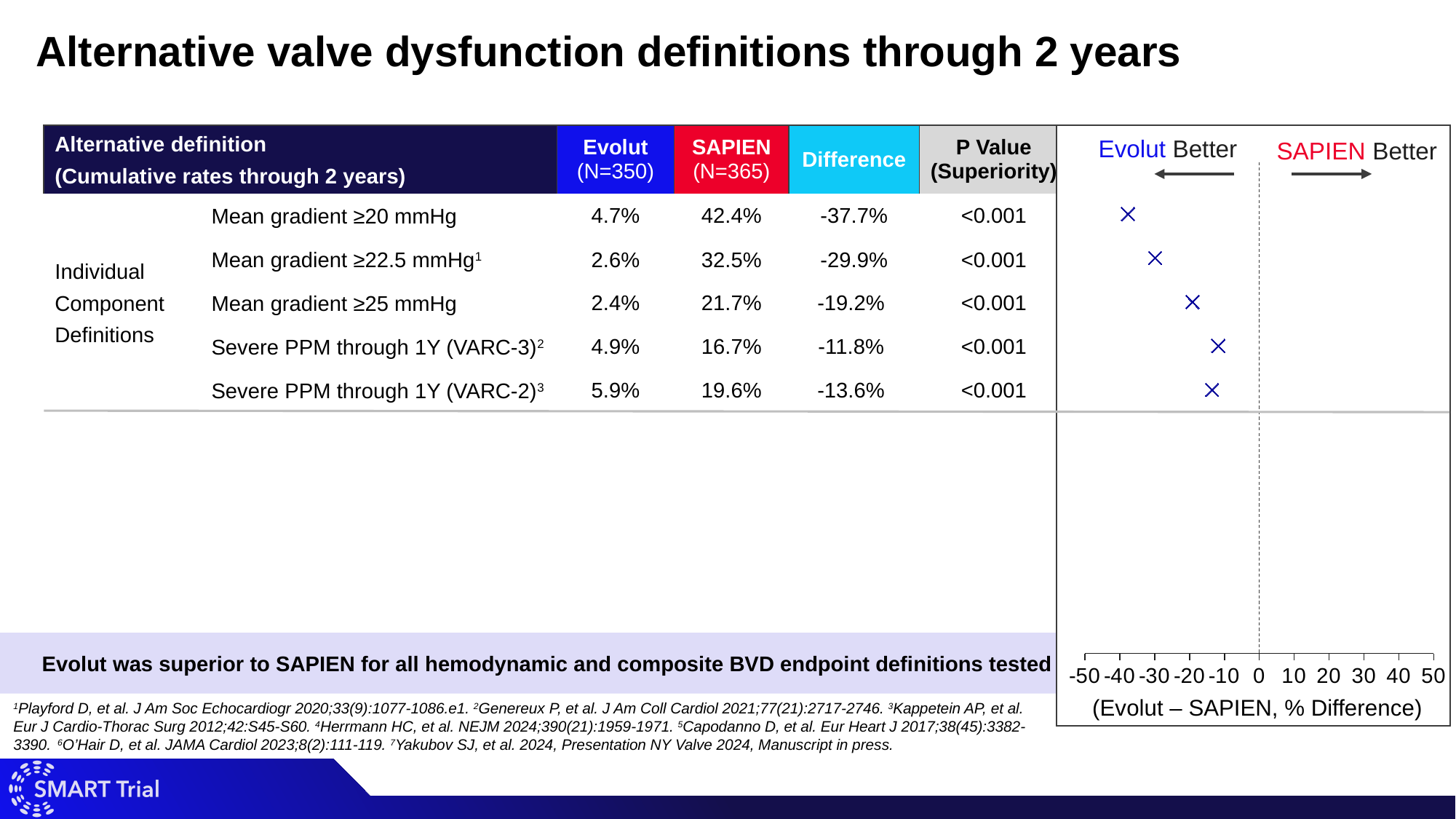
What is the label of the x axis of the chart? (Evolut – SAPIEN, % Difference) For Mean gradient ≥25 mmHg, which valve has the higher cumulative rate, Evolut or SAPIEN? SAPIEN Which definition has the difference closest to zero on the chart? Severe PPM through 1Y (VARC-3) What is the plotted difference (Evolut – SAPIEN) for Mean gradient ≥20 mmHg? -37.7% Which definition has the most negative difference, i.e. the point plotted furthest to the left on the chart? Mean gradient ≥20 mmHg What is the difference between the SAPIEN rates for Mean gradient ≥20 mmHg and Mean gradient ≥25 mmHg? 20.7 percentage points How many data points are plotted on the chart? 5 What kind of chart is shown on the right of the slide? Scatter (dot) plot What is the SAPIEN cumulative rate for Mean gradient ≥22.5 mmHg? 32.5% What is the Evolut cumulative rate for Severe PPM through 1Y (VARC-2)? 5.9% On which side of the chart's zero line is the region labelled 'Evolut Better'? Left Is the plotted difference for Mean gradient ≥22.5 mmHg greater or less than -20? less